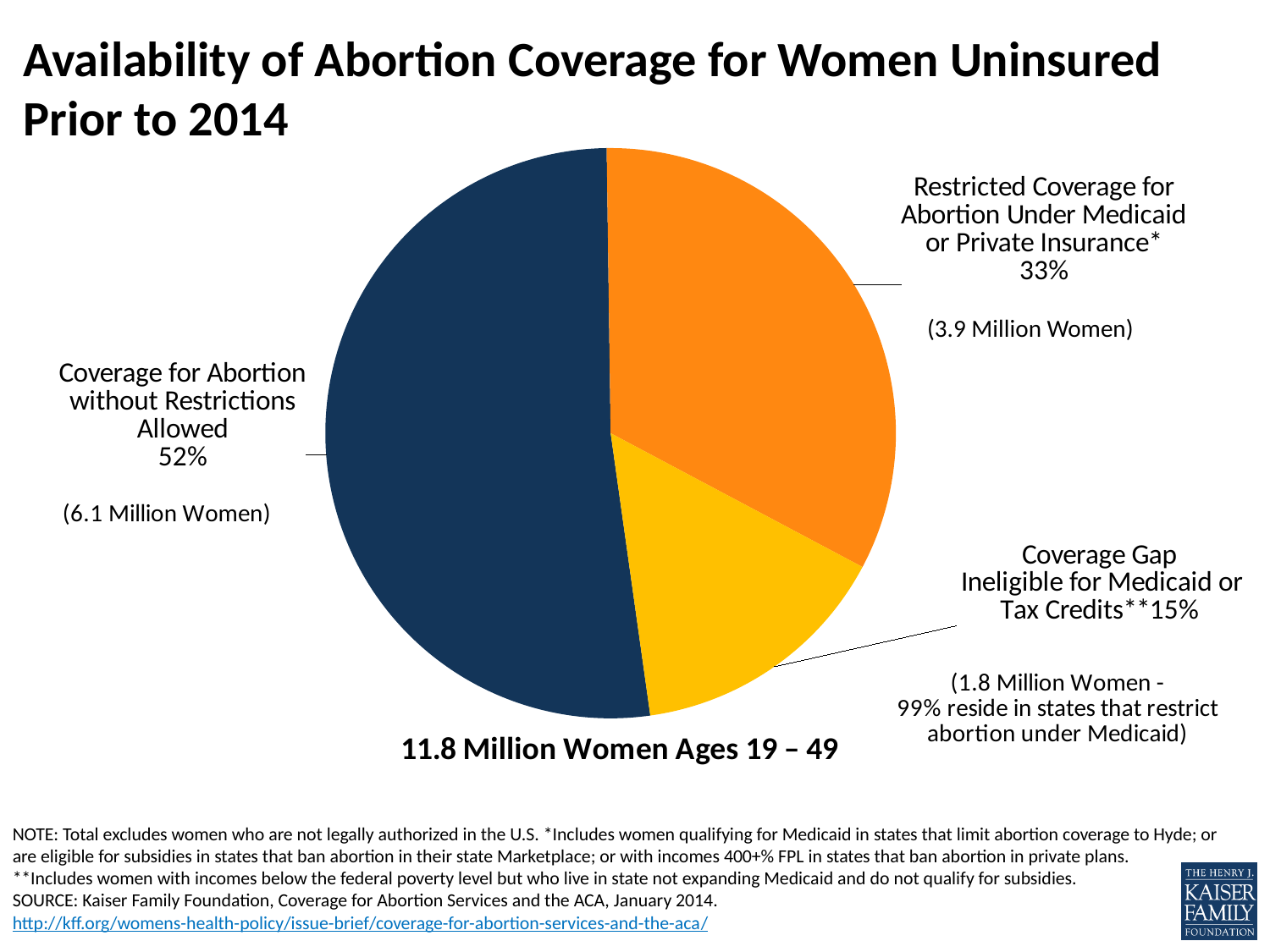
How many slices does the pie chart have? 3 How many million women are in the Coverage Gap? 1.8 Million Women How many million women have Coverage for Abortion without Restrictions Allowed? 6.1 Million Women What percentage of women have Coverage for Abortion without Restrictions Allowed? 52% What percentage of women fall in the Coverage Gap, Ineligible for Medicaid or Tax Credits? 15% What total number of women does the pie chart represent, according to the label below it? 11.8 Million Women Ages 19 – 49 Which category has the smallest share of the pie? Coverage Gap Ineligible for Medicaid or Tax Credits How many million women have Restricted Coverage for Abortion Under Medicaid or Private Insurance? 3.9 Million Women What percentage of women have Restricted Coverage for Abortion Under Medicaid or Private Insurance? 33% What type of chart is shown on the slide? Pie chart What is the difference in percentage points between Coverage for Abortion without Restrictions Allowed and Restricted Coverage for Abortion Under Medicaid or Private Insurance? 19 percentage points Which category has the largest share of the pie? Coverage for Abortion without Restrictions Allowed